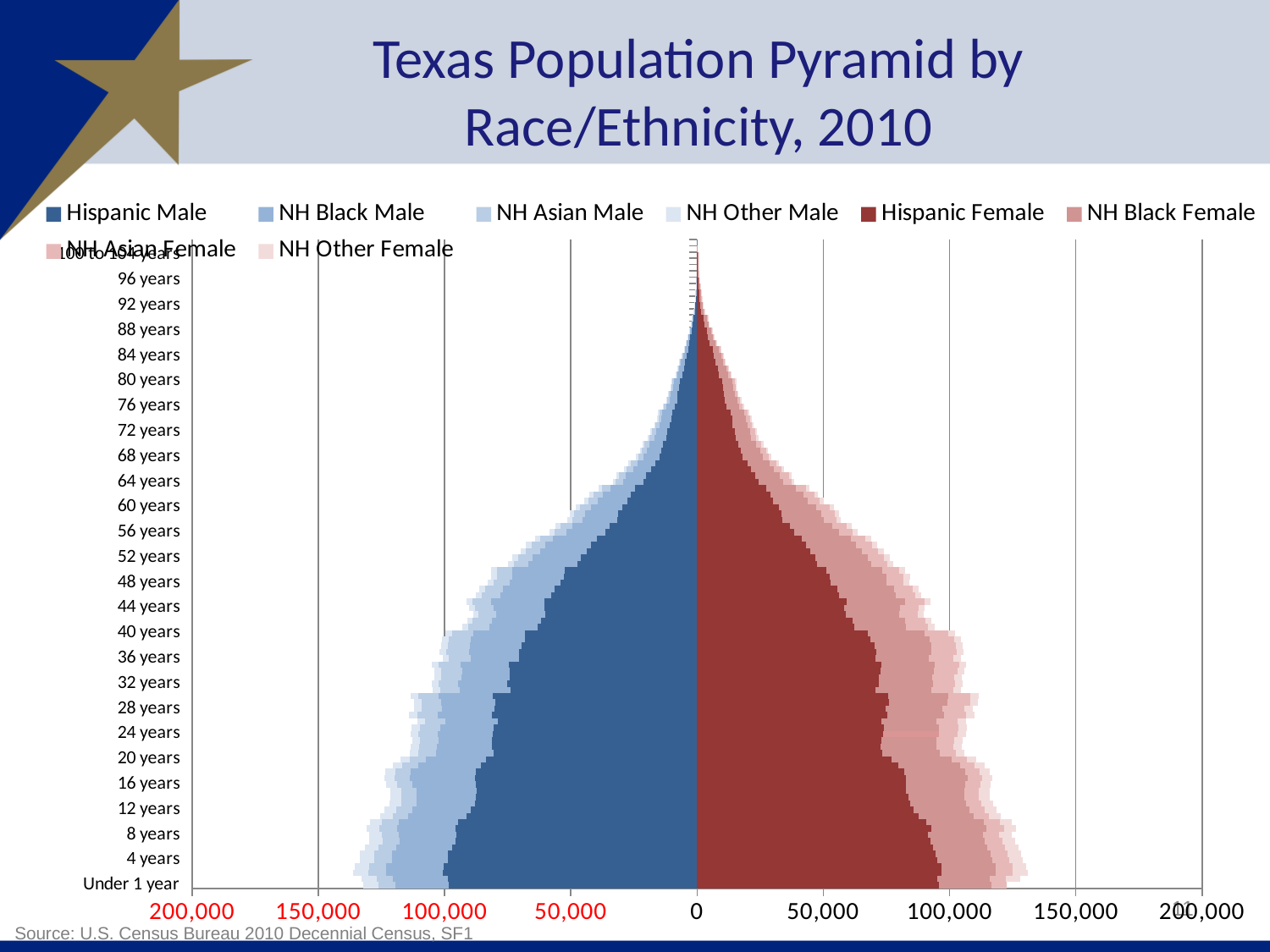
What kind of chart is shown on the slide? Bar chart (population pyramid) Is the total female population at Under 1 year (all races combined) greater or less than 100,000? greater Is the value for Hispanic Female at Under 1 year greater or less than 50,000? greater What is the title of the chart? Texas Population Pyramid by Race/Ethnicity, 2010 Is the value for Hispanic Female at 60 years greater or less than 50,000? less Do the total population values generally rise or fall as age increases from Under 1 year to 100 to 104 years? fall Which is larger for Hispanic Male: the value at Under 1 year or the value at 60 years? Under 1 year Which series is shown in the darkest blue on the left side of the pyramid? Hispanic Male How many series does the legend list? 8